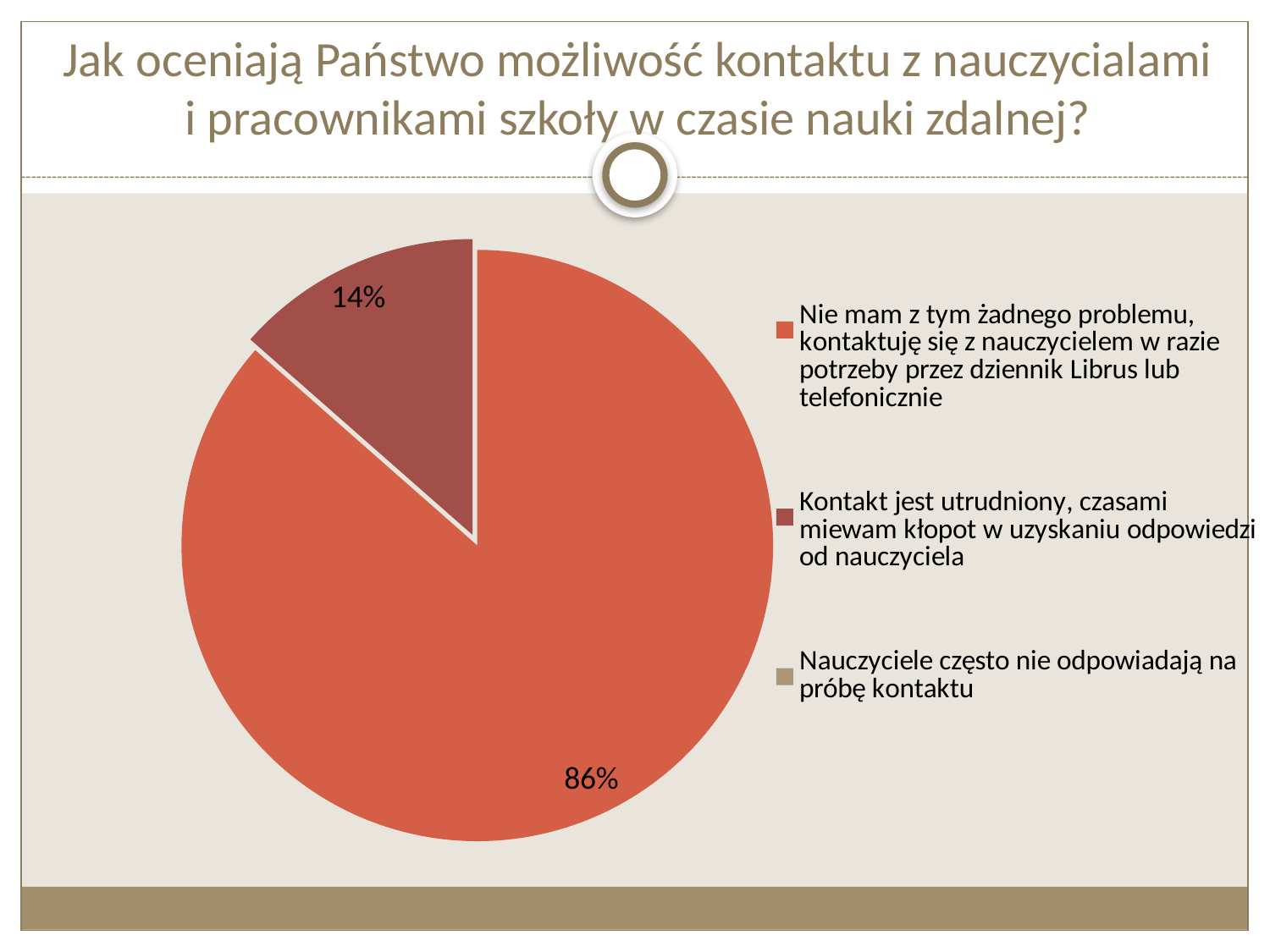
What kind of chart is shown on the slide? pie chart What is the total of the two labelled slices? 100% Is the share for "Kontakt jest utrudniony..." greater or less than 50%? less Which is larger: the share for "Nie mam z tym żadnego problemu..." or the share for "Kontakt jest utrudniony..."? Nie mam z tym żadnego problemu... Which legend entry is shown with a dark red marker? Kontakt jest utrudniony, czasami miewam kłopot w uzyskaniu odpowiedzi od nauczyciela Which category has the largest slice of the pie? Nie mam z tym żadnego problemu, kontaktuję się z nauczycielem w razie potrzeby przez dziennik Librus lub telefonicznie What colour is the slice labelled 86%? red-orange How many slices with a visible data label are shown in the pie? 2 How many entries does the legend list? 3 What share of the pie does the slice "Nie mam z tym żadnego problemu, kontaktuję się z nauczycielem w razie potrzeby przez dziennik Librus lub telefonicznie" represent? 86% What is the difference in percentage points between the largest slice and the 14% slice? 72% What share of the pie does the slice "Kontakt jest utrudniony, czasami miewam kłopot w uzyskaniu odpowiedzi od nauczyciela" represent? 14%